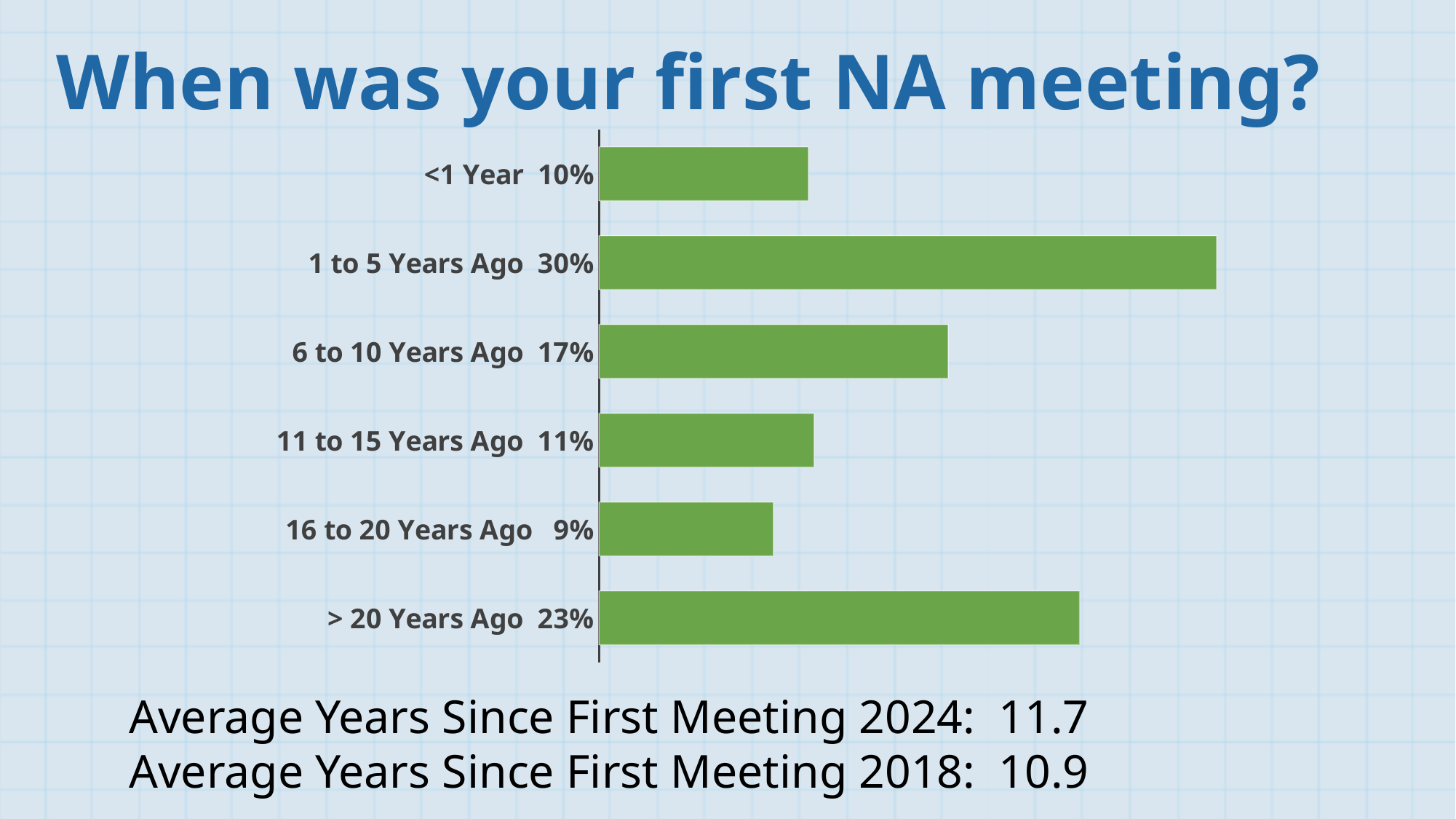
Which category has the highest percentage? 1 to 5 Years Ago Which category has the lowest percentage? 16 to 20 Years Ago What percentage of respondents had their first NA meeting 6 to 10 years ago? 17% What percentage of respondents had their first NA meeting less than 1 year ago? 10% What is the difference in percentage points between the 1 to 5 Years Ago and > 20 Years Ago categories? 7 Which is larger, the percentage for 6 to 10 Years Ago or for 11 to 15 Years Ago? 6 to 10 Years Ago How many categories are shown in the chart? 6 What is the average number of years since first meeting reported for 2024? 11.7 What percentage of respondents had their first NA meeting 1 to 5 years ago? 30% What percentage of respondents had their first NA meeting more than 20 years ago? 23% What colour are the bars in the chart? Green What kind of chart is shown on the slide? Bar chart